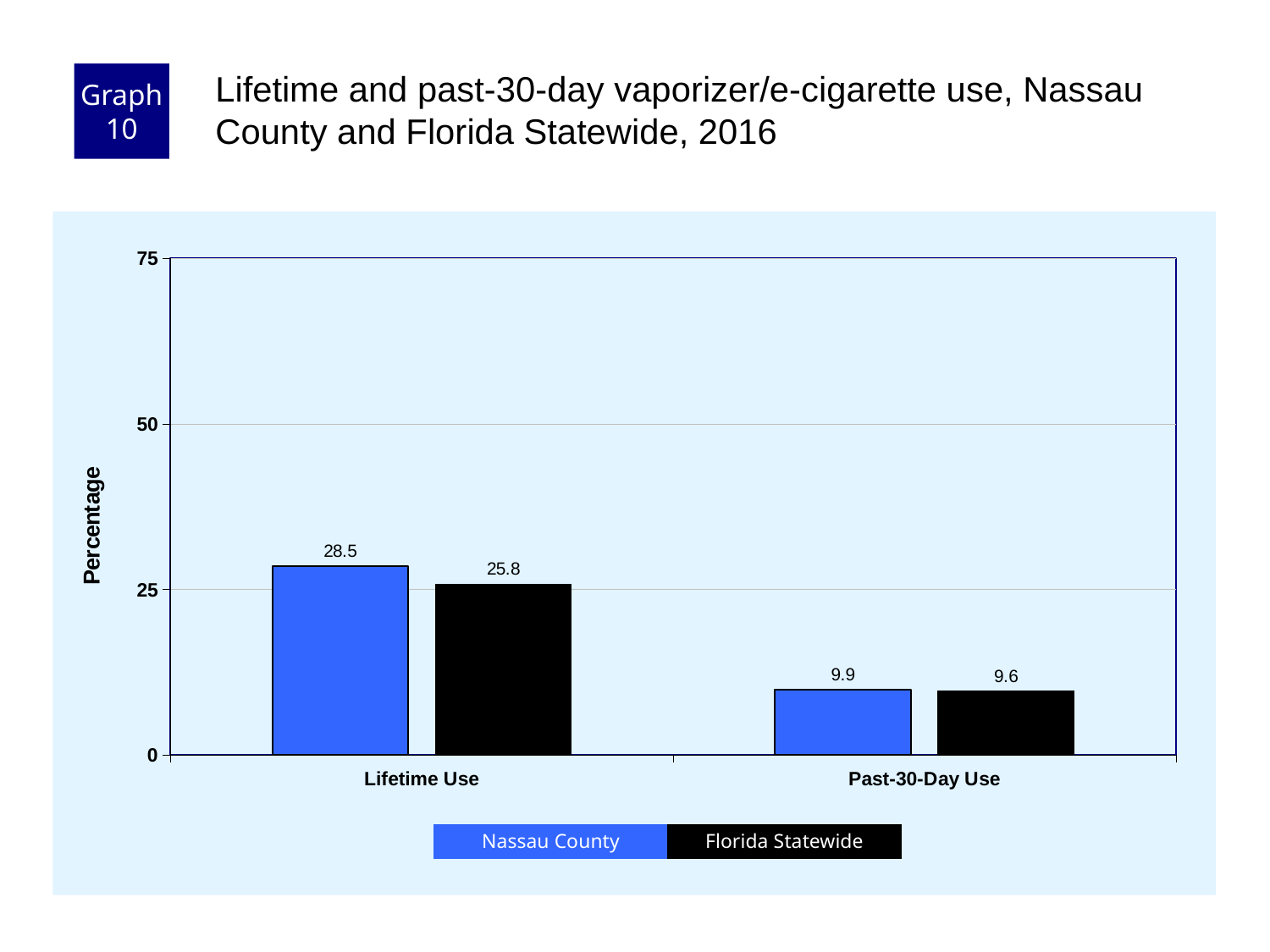
How many series does the legend list? 2 What is the Florida Statewide value for Past-30-Day Use? 9.6 Is the Nassau County value for Lifetime Use greater or less than 25? greater How many categories are shown on the x axis? 2 What is the label on the y axis? Percentage What kind of chart is shown on the slide? bar chart What is the Nassau County value for Lifetime Use? 28.5 Which category has the lowest Florida Statewide value? Past-30-Day Use For Past-30-Day Use, which is larger: Nassau County or Florida Statewide? Nassau County What is the difference between the Nassau County and Florida Statewide values for Lifetime Use? 2.7 What is the Florida Statewide value for Lifetime Use? 25.8 Which category has the highest Nassau County value? Lifetime Use